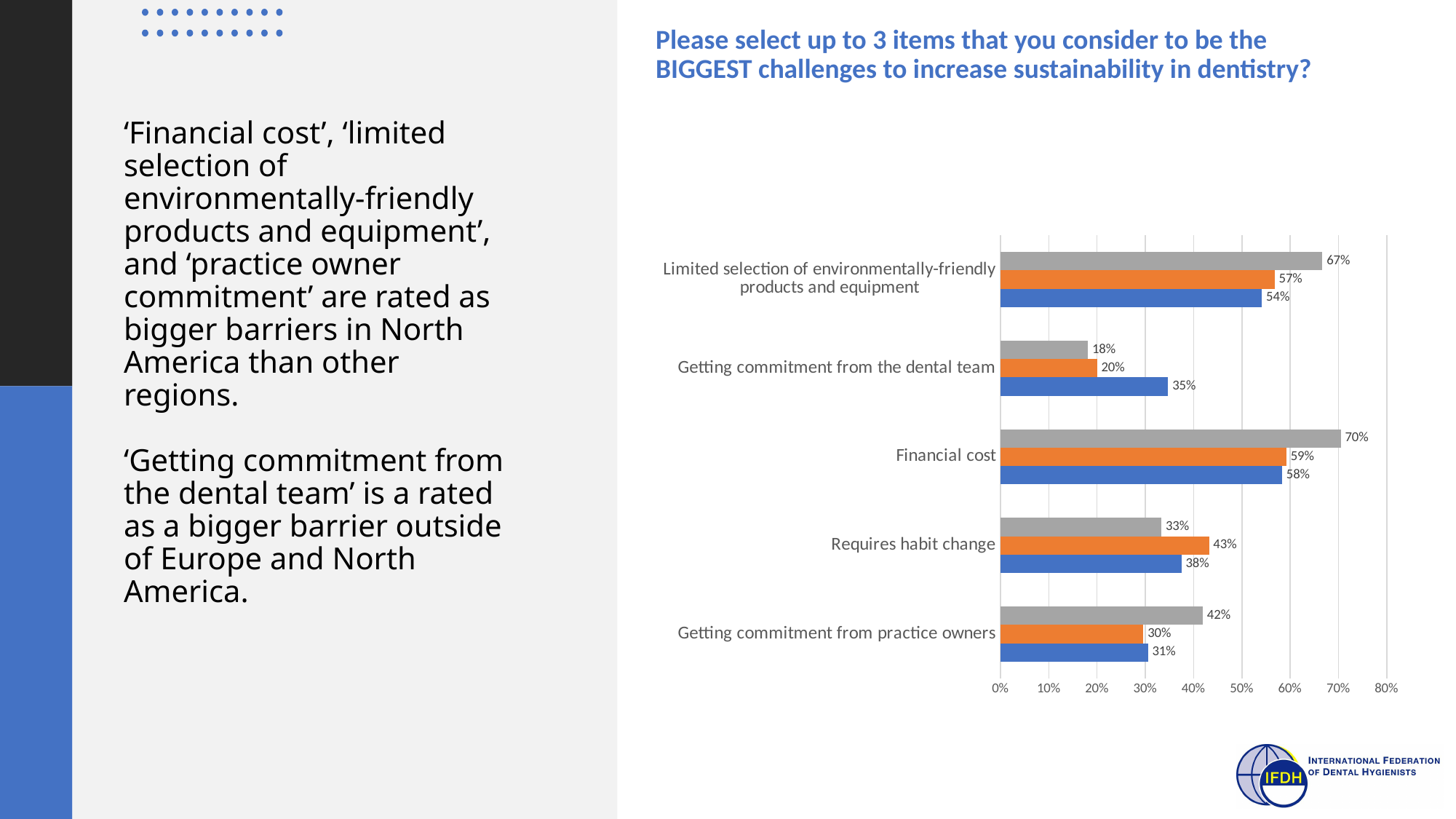
How many categories are shown on the chart? 5 What is the value of the grey bar for 'Getting commitment from practice owners'? 42% What type of chart is shown on the slide? bar chart What is the value of the blue bar for 'Getting commitment from the dental team'? 35% What is the value of the grey bar for 'Financial cost'? 70% Which category has the highest grey bar value? Financial cost What is the value of the orange bar for 'Requires habit change'? 43% How many bars are shown for each category on the chart? 3 What is the difference between the grey bar and the blue bar for 'Limited selection of environmentally-friendly products and equipment'? 13% For 'Getting commitment from the dental team', which is larger: the blue bar or the orange bar? the blue bar What is the difference between the orange bar and the grey bar for 'Requires habit change'? 10% Which category has the lowest grey bar value? Getting commitment from the dental team